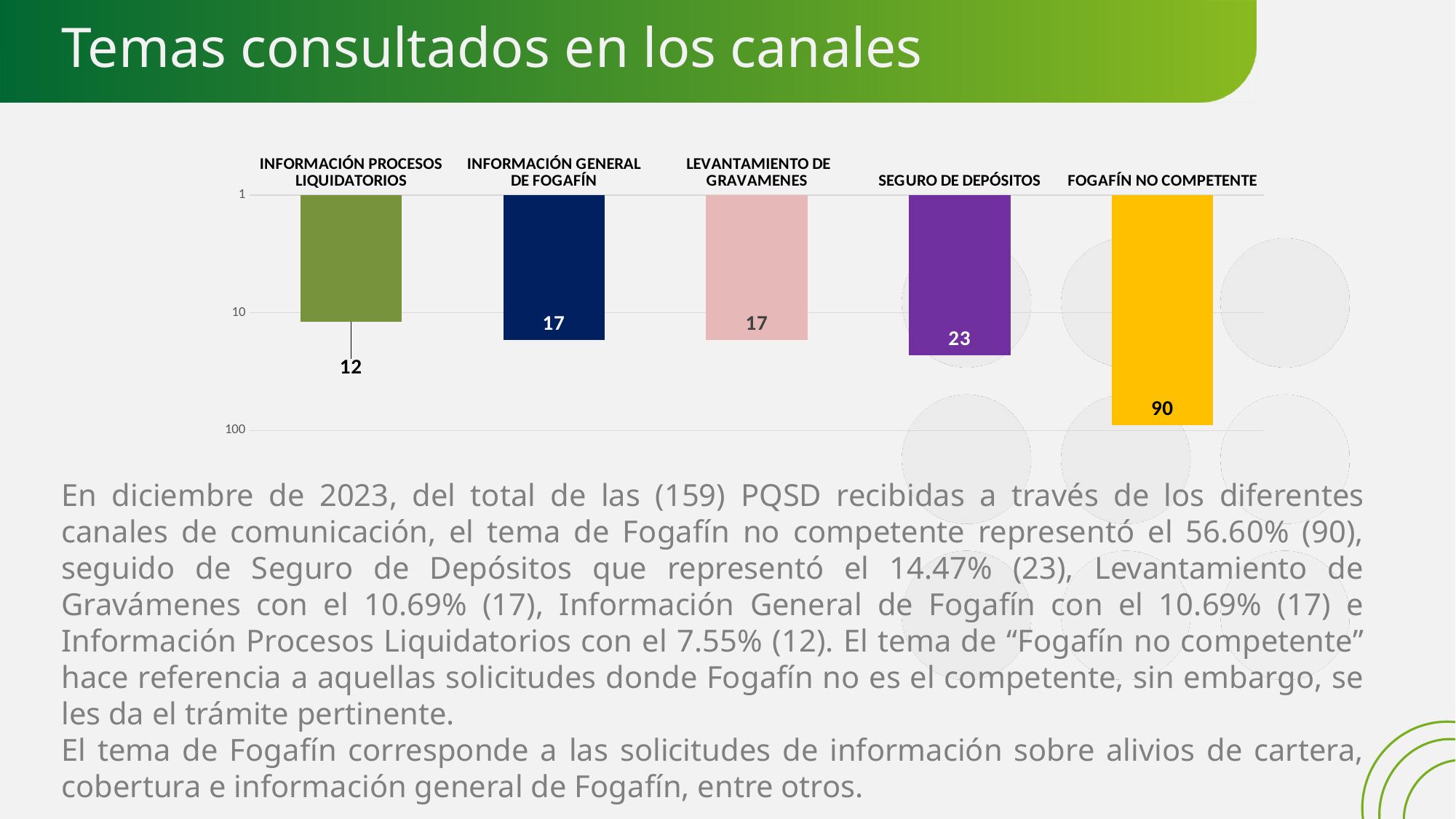
Which category has the lowest value? INFORMACIÓN PROCESOS LIQUIDATORIOS Is the value for FOGAFÍN NO COMPETENTE greater or less than 10? greater What is the value for SEGURO DE DEPÓSITOS? 23 Which is larger, the value for SEGURO DE DEPÓSITOS or the value for INFORMACIÓN GENERAL DE FOGAFÍN? SEGURO DE DEPÓSITOS Do the values rise or fall from left to right across the categories? rise What is the value for INFORMACIÓN PROCESOS LIQUIDATORIOS? 12 What is the value for FOGAFÍN NO COMPETENTE? 90 What kind of chart is shown on the slide? bar chart How many categories are shown in the chart? 5 Which category has the highest value? FOGAFÍN NO COMPETENTE What is the value for LEVANTAMIENTO DE GRAVAMENES? 17 What is the difference between the values for FOGAFÍN NO COMPETENTE and SEGURO DE DEPÓSITOS? 67